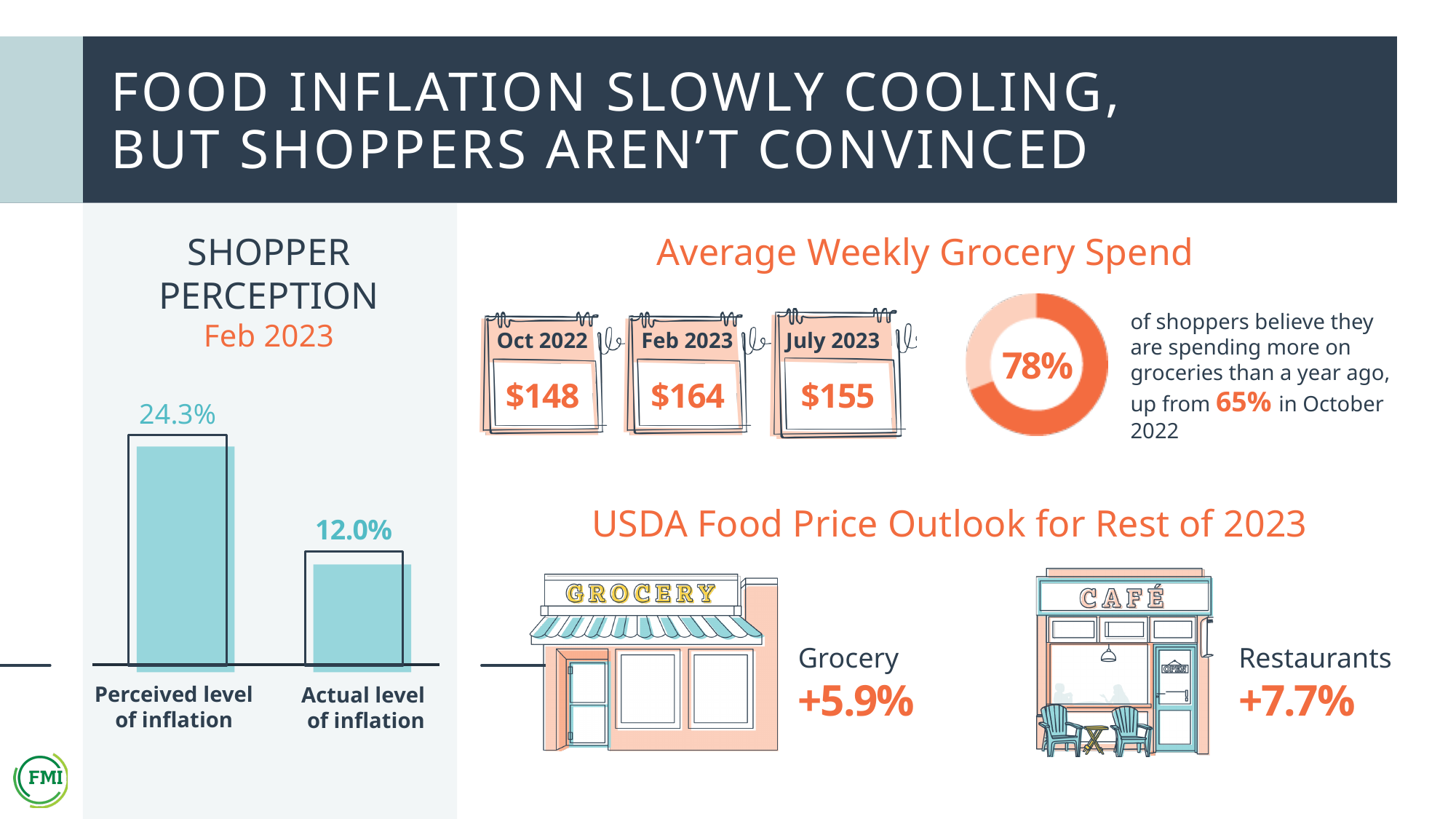
What kind of chart shows the 78% of shoppers who believe they are spending more on groceries? donut chart In the Shopper Perception chart, which category has the higher value? Perceived level of inflation Which month and year does the Shopper Perception chart refer to? Feb 2023 What percentage is shown in the donut chart next to the Average Weekly Grocery Spend section? 78% What kind of chart is the Shopper Perception chart? bar chart In the Shopper Perception chart, what is the value for the perceived level of inflation? 24.3% In the Shopper Perception chart, what is the value for the actual level of inflation? 12.0% What colour are the bars in the Shopper Perception chart? light blue In the Shopper Perception chart, which category has the lower value? Actual level of inflation How many bars are in the Shopper Perception chart? 2 In the Shopper Perception chart, is the perceived level of inflation larger or smaller than the actual level of inflation? larger In the Shopper Perception chart, what is the difference between the perceived level of inflation and the actual level of inflation? 12.3%